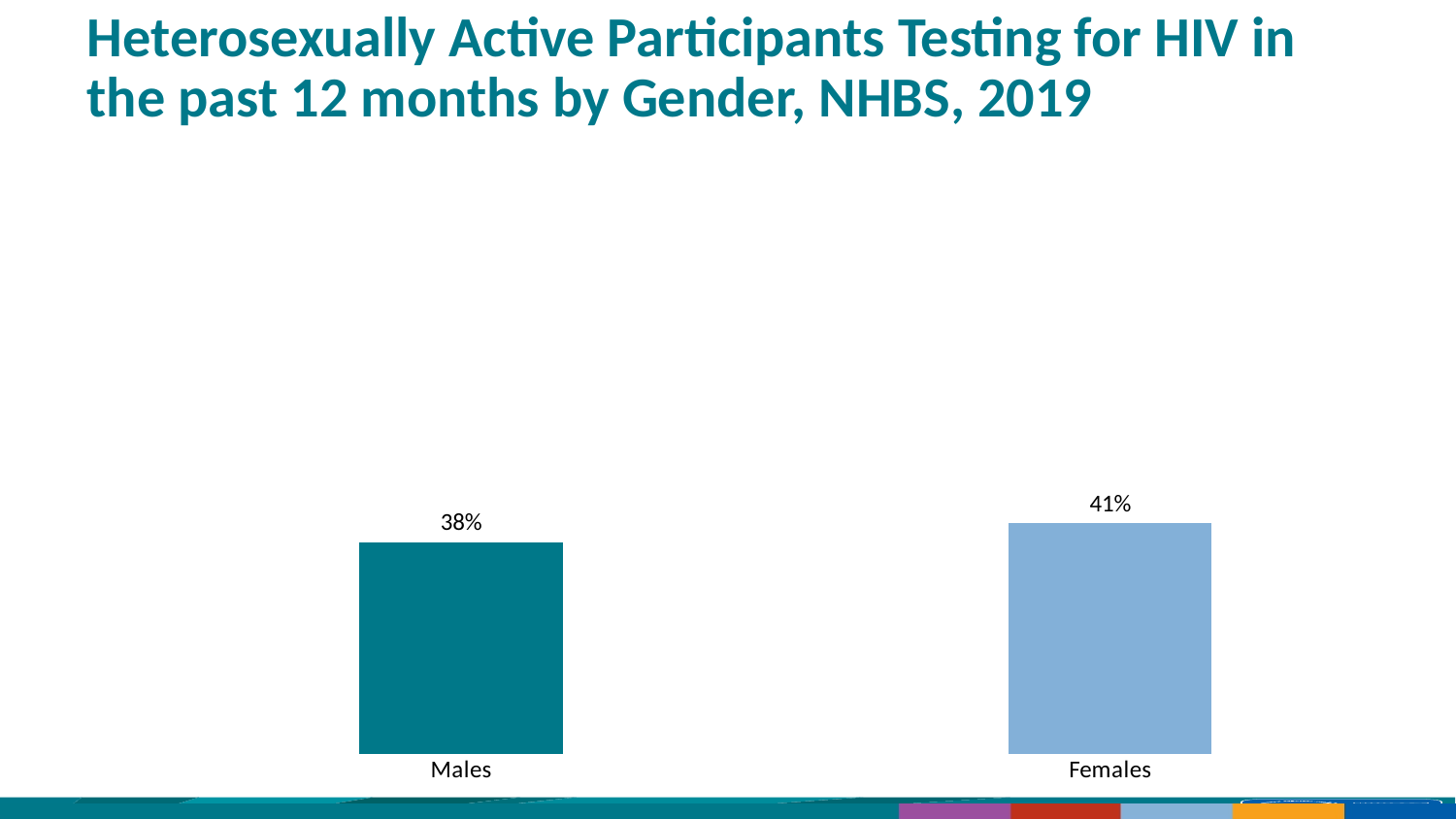
Which gender has the higher percentage of participants testing for HIV in the past 12 months? Females What percentage of heterosexually active males tested for HIV in the past 12 months? 38% How many gender categories are shown in the chart? 2 Which gender has the lower percentage of participants testing for HIV in the past 12 months? Males What percentage of heterosexually active females tested for HIV in the past 12 months? 41% Is the value for Males larger or smaller than the value for Females? smaller What is the difference in percentage points between females and males testing for HIV in the past 12 months? 3 percentage points What colour is the bar for Females? Light blue What year of NHBS data does the chart present? 2019 What type of chart is shown on the slide? Bar chart